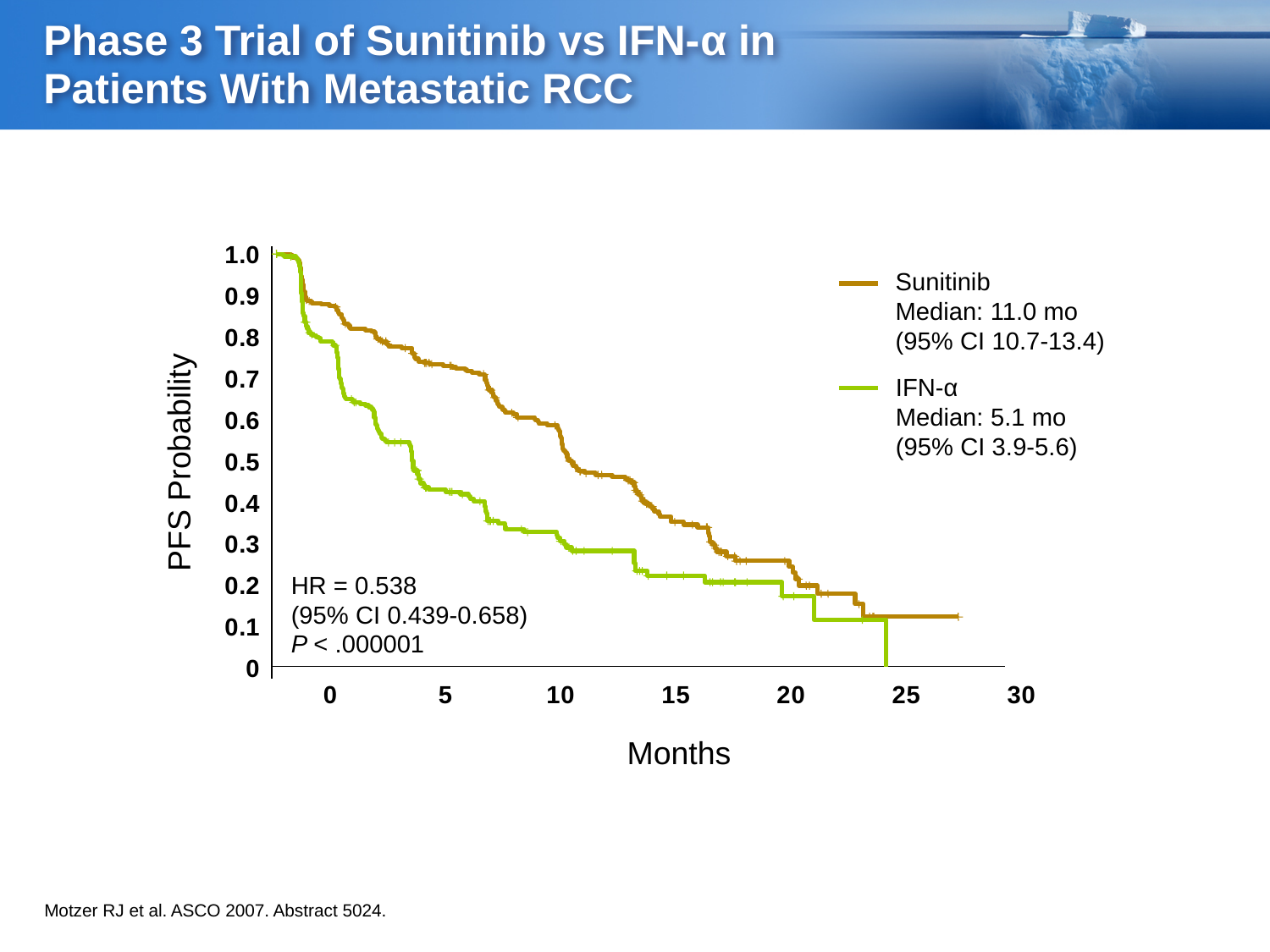
Is the PFS probability for IFN-α at 5 months greater or less than 0.5? less What is the median PFS for Sunitinib? 11.0 mo What is the label of the y axis? PFS Probability What kind of chart is shown on the slide? line chart What is the 95% CI for the Sunitinib median PFS? 10.7-13.4 What is the median PFS for IFN-α? 5.1 mo What is the 95% CI for the IFN-α median PFS? 3.9-5.6 Do the PFS probability curves rise or fall as months increase? fall What is the difference between the median PFS of Sunitinib and IFN-α? 5.9 mo Which treatment has the longer median PFS, Sunitinib or IFN-α? Sunitinib What is the hazard ratio (HR) shown on the chart? 0.538 How many series does the legend list? 2